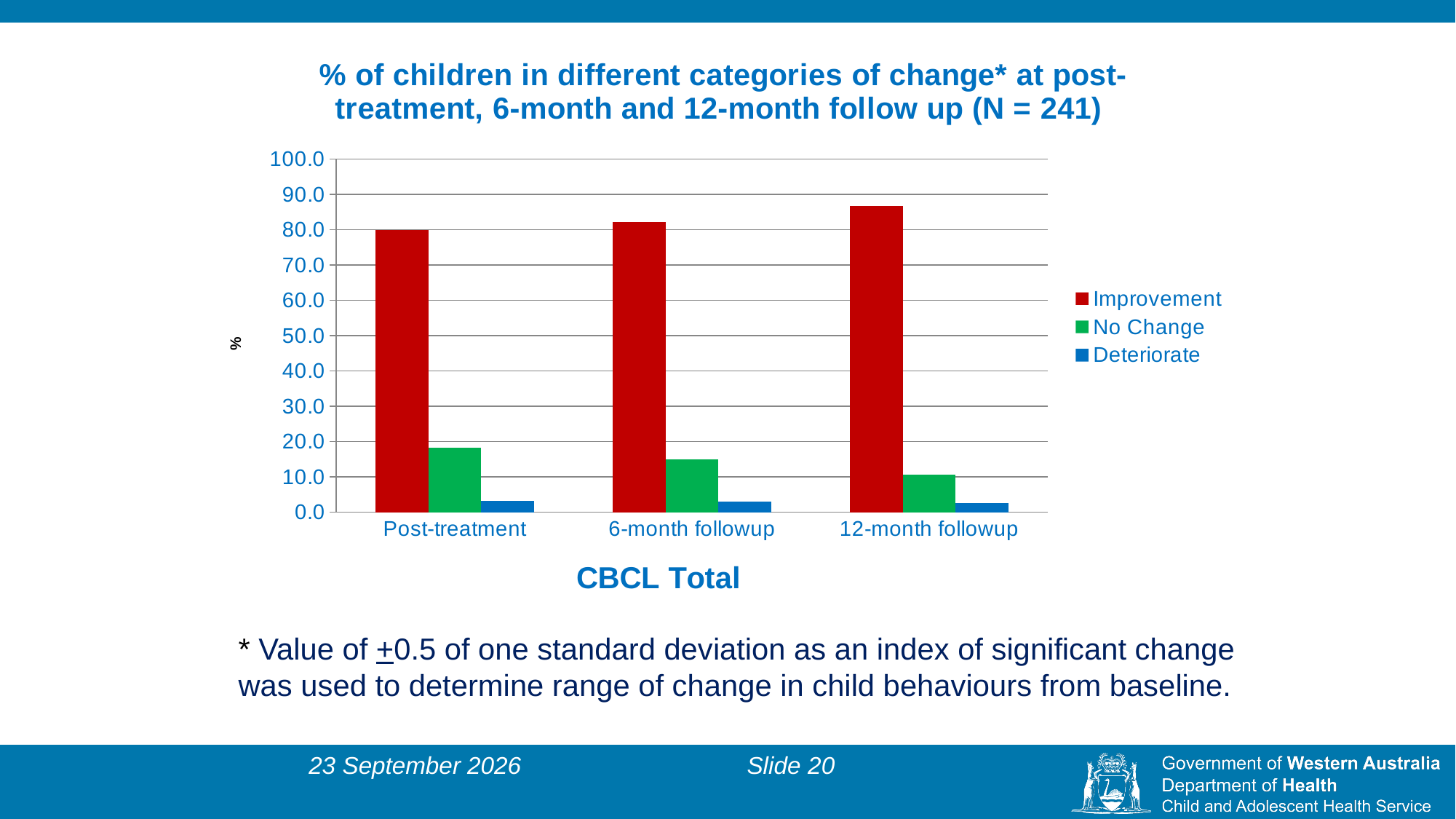
At which time point is the Improvement value highest? 12-month followup What is the x-axis title of the chart? CBCL Total What kind of chart is shown on the slide? bar chart How many series does the legend list? 3 At which time point is the No Change value lowest? 12-month followup Is the Improvement value at 12-month followup greater or less than 80.0? greater Is the Improvement value at Post-treatment greater or less than 70.0? greater Is the Deteriorate value at Post-treatment greater or less than 10.0? less Which is larger: the Improvement value at Post-treatment or at 12-month followup? 12-month followup How many categories are shown on the x axis? 3 Do the No Change values rise or fall from Post-treatment to 12-month followup? fall